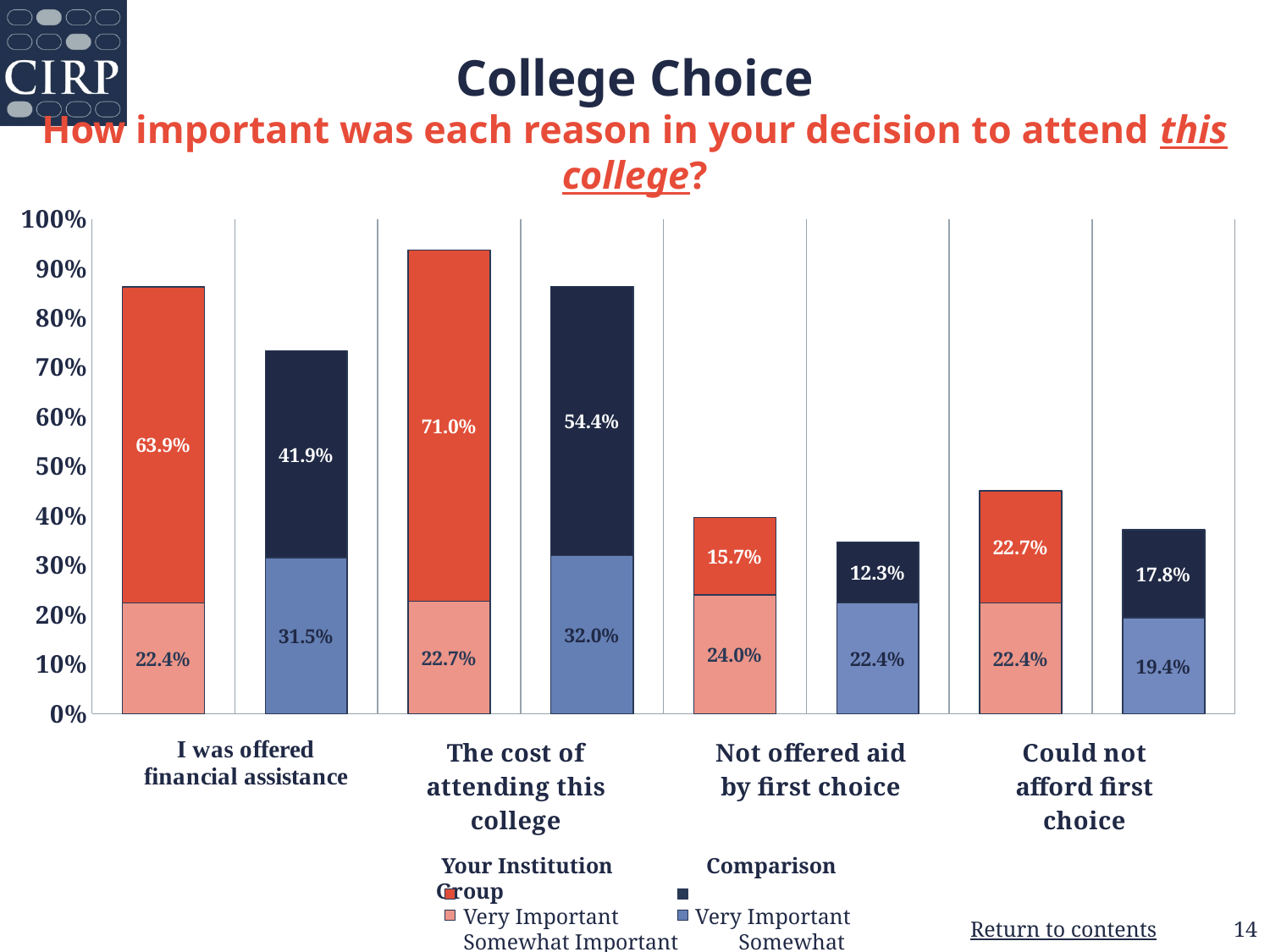
For "Could not afford first choice", is the Very Important value higher for Your Institution or the Comparison Group? Your Institution What is the total stacked height of the Comparison Group bar for "Not offered aid by first choice"? 34.7% How many reasons (categories) are shown on the x axis of the chart? 4 What is the difference between Your Institution's and the Comparison Group's Very Important values for "I was offered financial assistance"? 22.0% Which reason has the highest Very Important percentage for Your Institution? The cost of attending this college What is the Comparison Group's Very Important value for "Not offered aid by first choice"? 12.3% How many series does the legend list? 4 What percentage of Comparison Group respondents rated "I was offered financial assistance" as Somewhat Important? 31.5% What is the total stacked height (Very Important plus Somewhat Important) of the Your Institution bar for "The cost of attending this college"? 93.7% What type of chart is shown on the slide? Stacked bar chart What percentage of Your Institution respondents rated "The cost of attending this college" as Very Important? 71.0% Which reason has the lowest Very Important percentage for the Comparison Group? Not offered aid by first choice